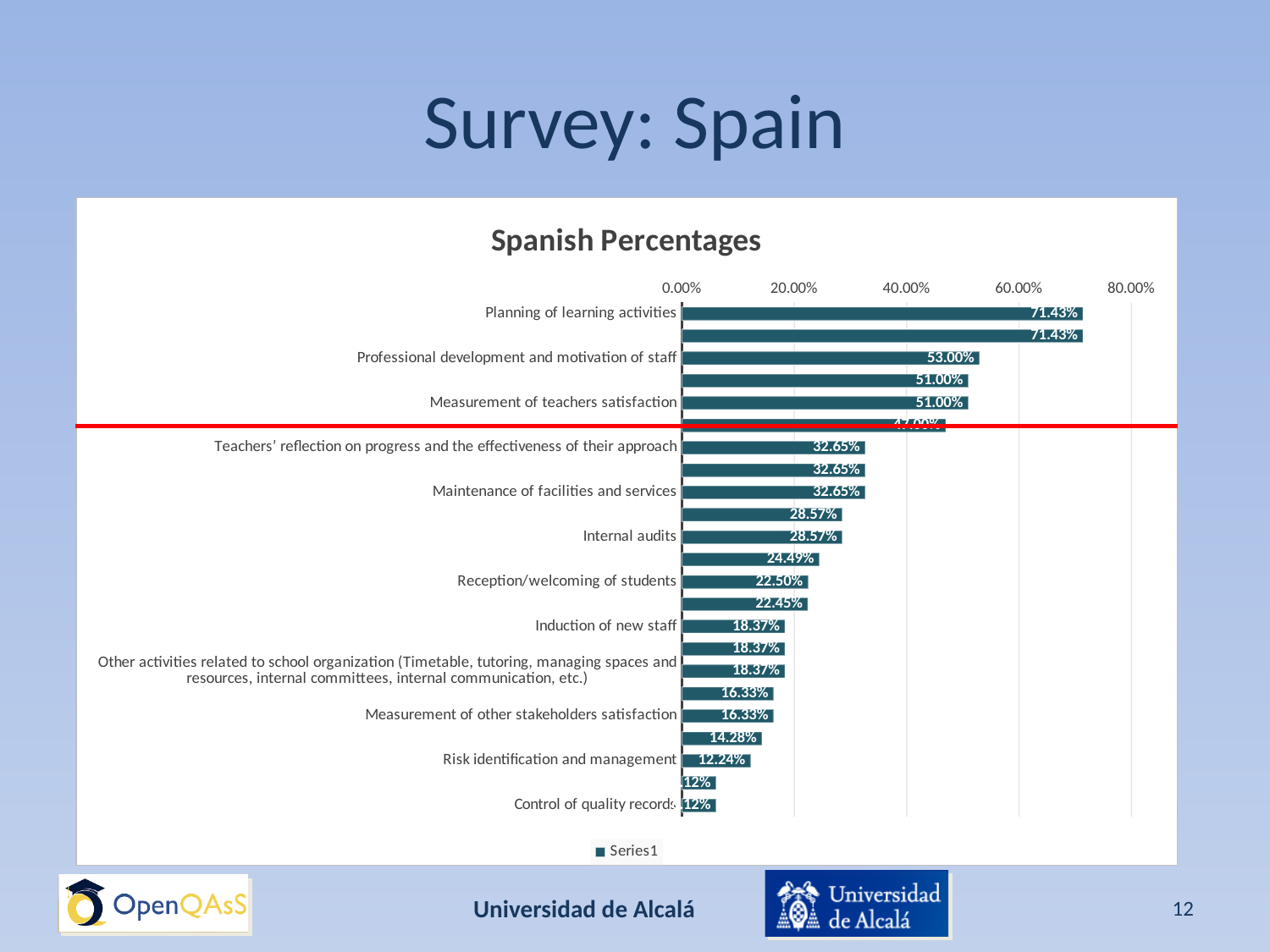
How many series does the legend list? 1 What is the value for Professional development and motivation of staff? 53.00% Which is larger: Maintenance of facilities and services or Internal audits? Maintenance of facilities and services What is the value for Internal audits? 28.57% What is the difference between Planning of learning activities and Professional development and motivation of staff? 18.43% What is the title of the chart? Spanish Percentages What type of chart is shown on the slide? Bar chart Which labeled category has the lowest value? Control of quality records What is the value for Risk identification and management? 12.24% Is the value for Measurement of teachers satisfaction greater or less than 40.00%? greater Which labeled category has the highest value? Planning of learning activities What is the value for Planning of learning activities? 71.43%